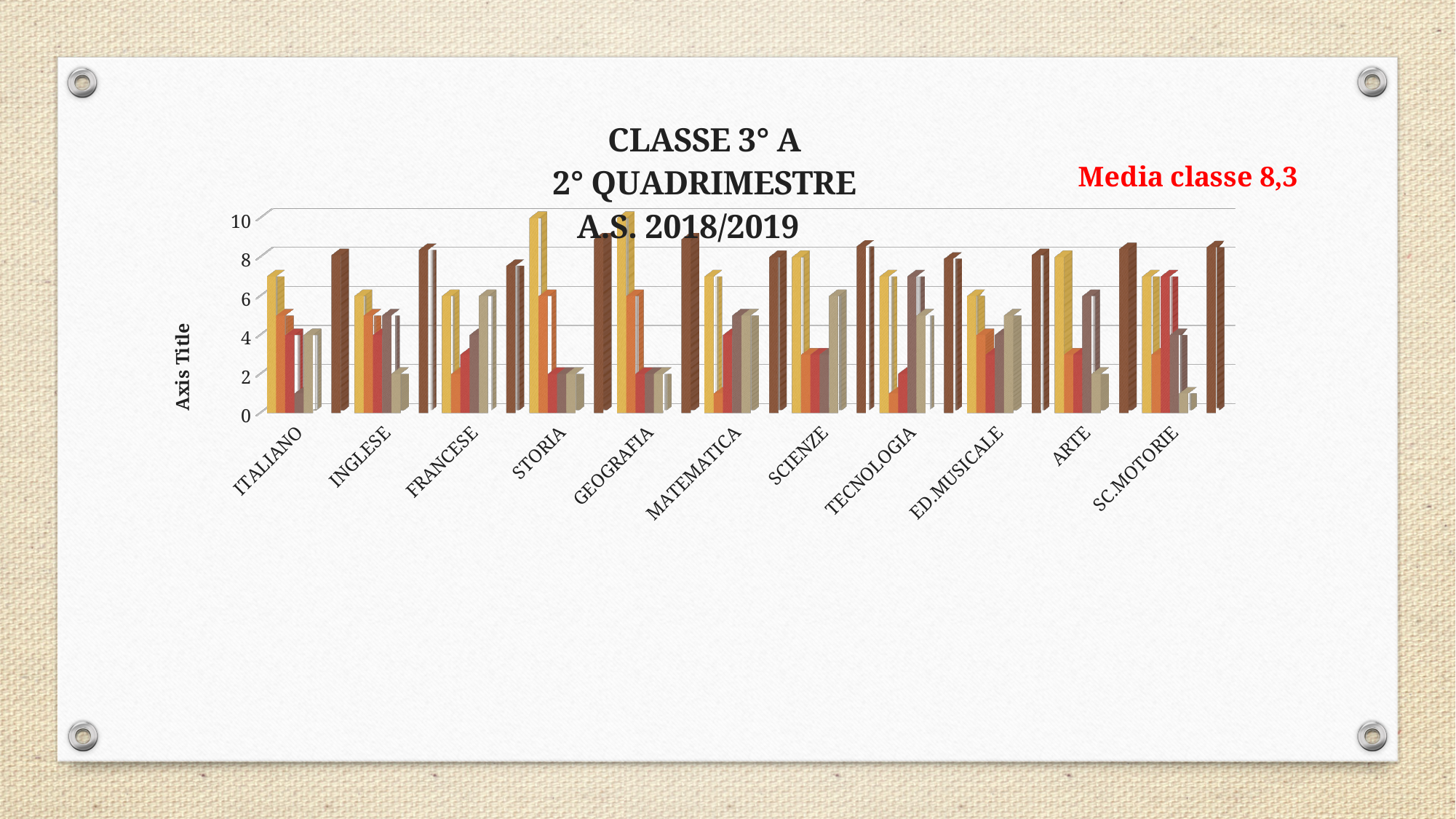
What is the title of the chart? CLASSE 3° A 2° QUADRIMESTRE A.S. 2018/2019 What kind of chart is shown on the slide? bar chart Is the value of the red bar for FRANCESE greater or less than 4? less How many subject categories are shown on the x axis of the chart? 11 Is the value of the tallest bar for STORIA greater or less than 8? greater Is the value of the red bar for ARTE greater or less than 4? less What label is shown on the vertical axis of the chart? Axis Title